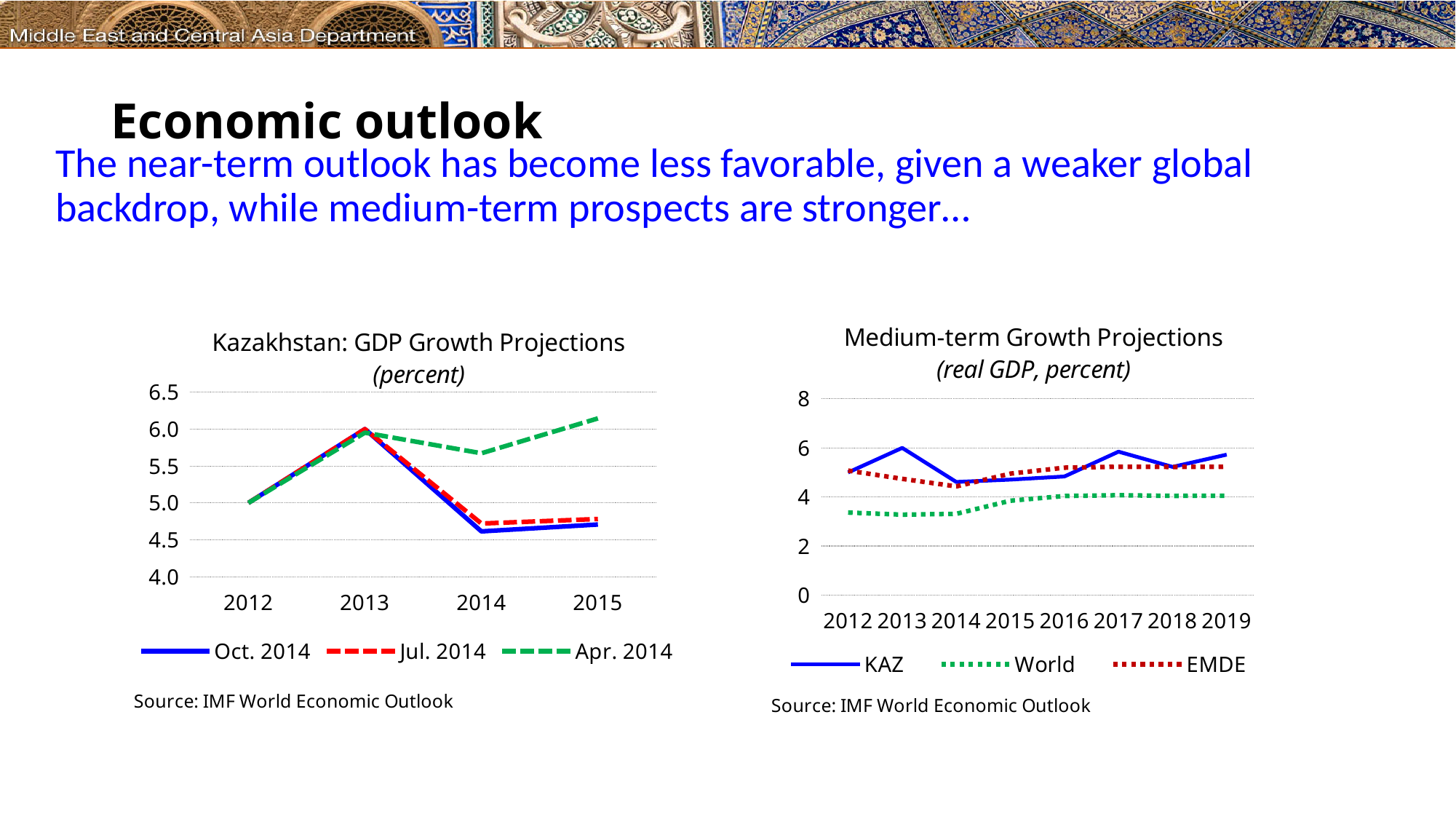
In the 'Medium-term Growth Projections' chart, which series has the lowest value in 2012? World In the 'Kazakhstan: GDP Growth Projections' chart, what kind of chart is shown? line chart In the 'Kazakhstan: GDP Growth Projections' chart, is the Oct. 2014 value for 2014 greater or less than 5.0? less In the 'Kazakhstan: GDP Growth Projections' chart, does the Oct. 2014 series rise or fall from 2013 to 2014? fall In the 'Kazakhstan: GDP Growth Projections' chart, which series has the highest value for 2015? Apr. 2014 In the 'Kazakhstan: GDP Growth Projections' chart, how many series does the legend list? 3 In the 'Medium-term Growth Projections' chart, is the World value for 2019 greater or less than 6? less In the 'Medium-term Growth Projections' chart, what is the KAZ value for 2013? 6 In the 'Kazakhstan: GDP Growth Projections' chart, how many years are shown on the x axis? 4 In the 'Kazakhstan: GDP Growth Projections' chart, what is the Oct. 2014 value for 2012? 5.0 In the 'Medium-term Growth Projections' chart, how many series does the legend list? 3